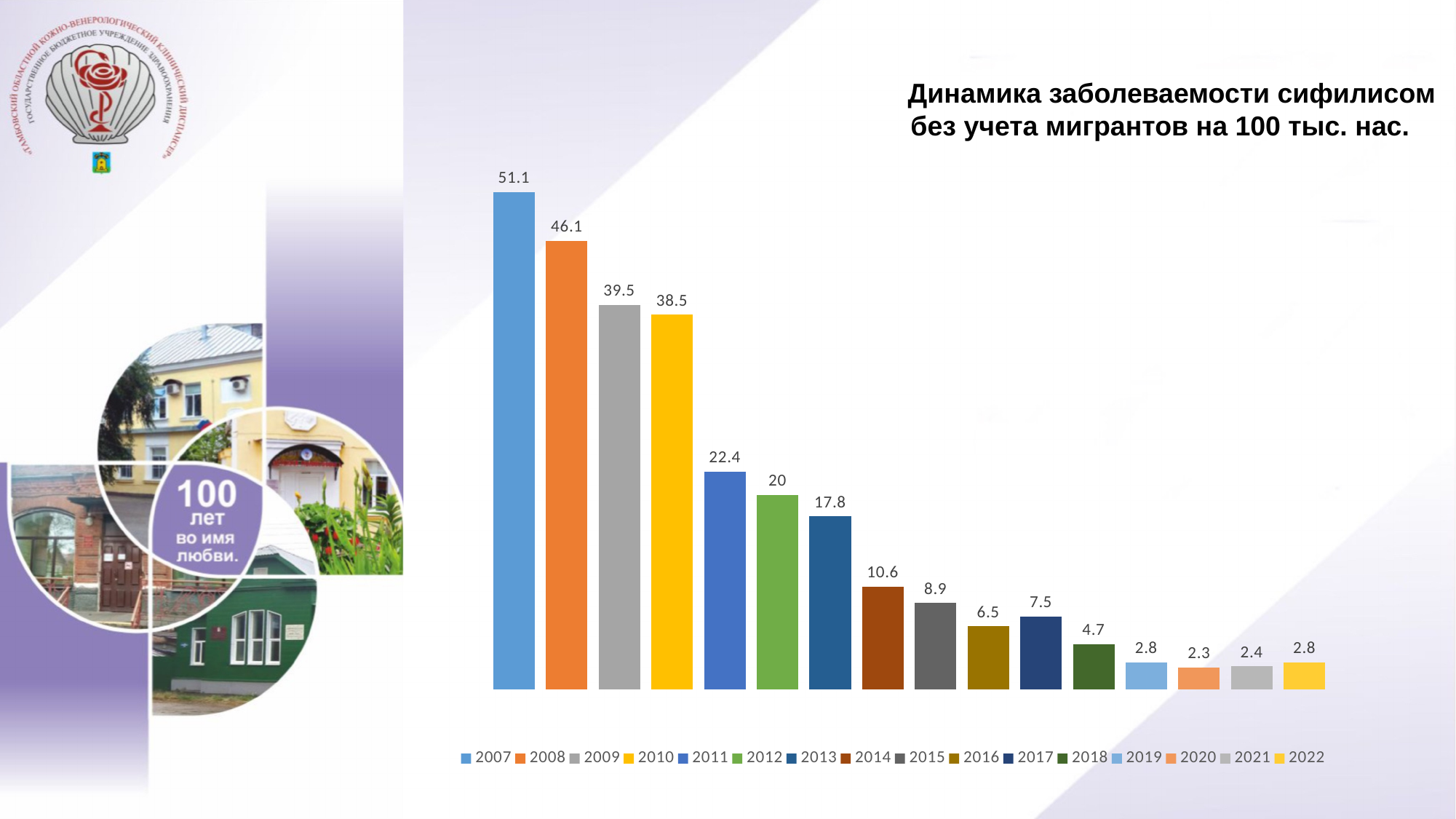
What is the value shown for 2013? 17.8 Do the values generally rise or fall from 2007 to 2022? fall What is the difference between the values for 2011 and 2012? 2.4 Which year has the highest value in the chart? 2007 Which year has the lowest value in the chart? 2020 How many entries does the legend list? 16 Which is larger, the value for 2016 or the value for 2017? 2017 What is the difference between the values for 2007 and 2008? 5 What is the value shown for 2020? 2.3 How many bars are plotted in the chart? 16 What is the syphilis incidence value shown for 2007? 51.1 What type of chart is shown on the slide? bar chart